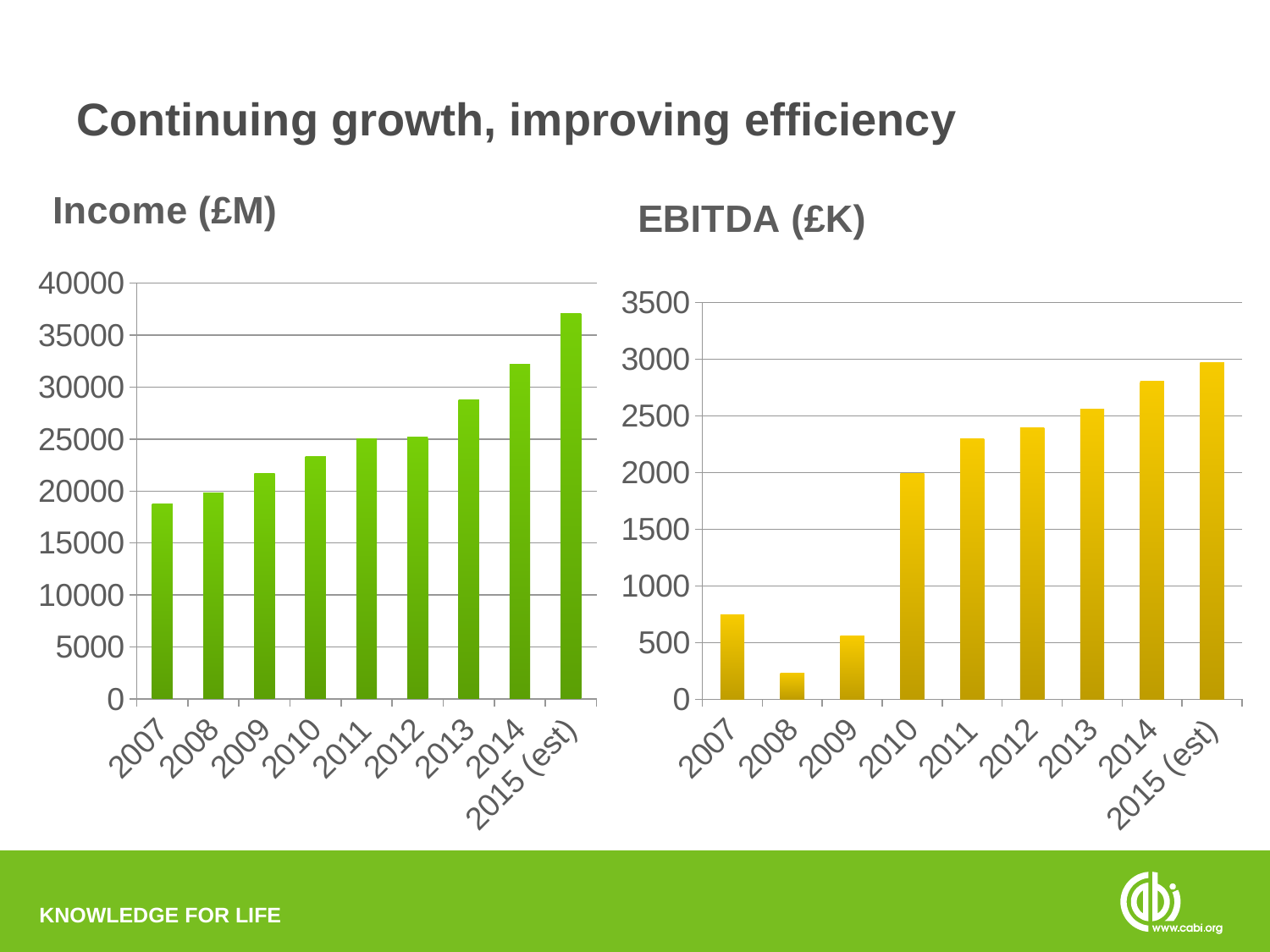
On the Income (£M) chart, is the value for 2007 greater or less than 20000? less On the Income (£M) chart, do the values generally rise or fall from 2007 to 2015 (est)? rise On the EBITDA (£K) chart, which is larger, the value for 2007 or the value for 2009? 2007 On the Income (£M) chart, is the value for 2015 (est) greater or less than 35000? greater On the EBITDA (£K) chart, is the value for 2014 greater or less than 2500? greater How many years are shown on the EBITDA (£K) chart? 9 What kind of chart is the Income (£M) chart? bar chart On the Income (£M) chart, which year has the lowest income? 2007 On the EBITDA (£K) chart, which year has the lowest EBITDA? 2008 On the Income (£M) chart, which year has the highest income? 2015 (est) On the EBITDA (£K) chart, which year has the highest EBITDA? 2015 (est)